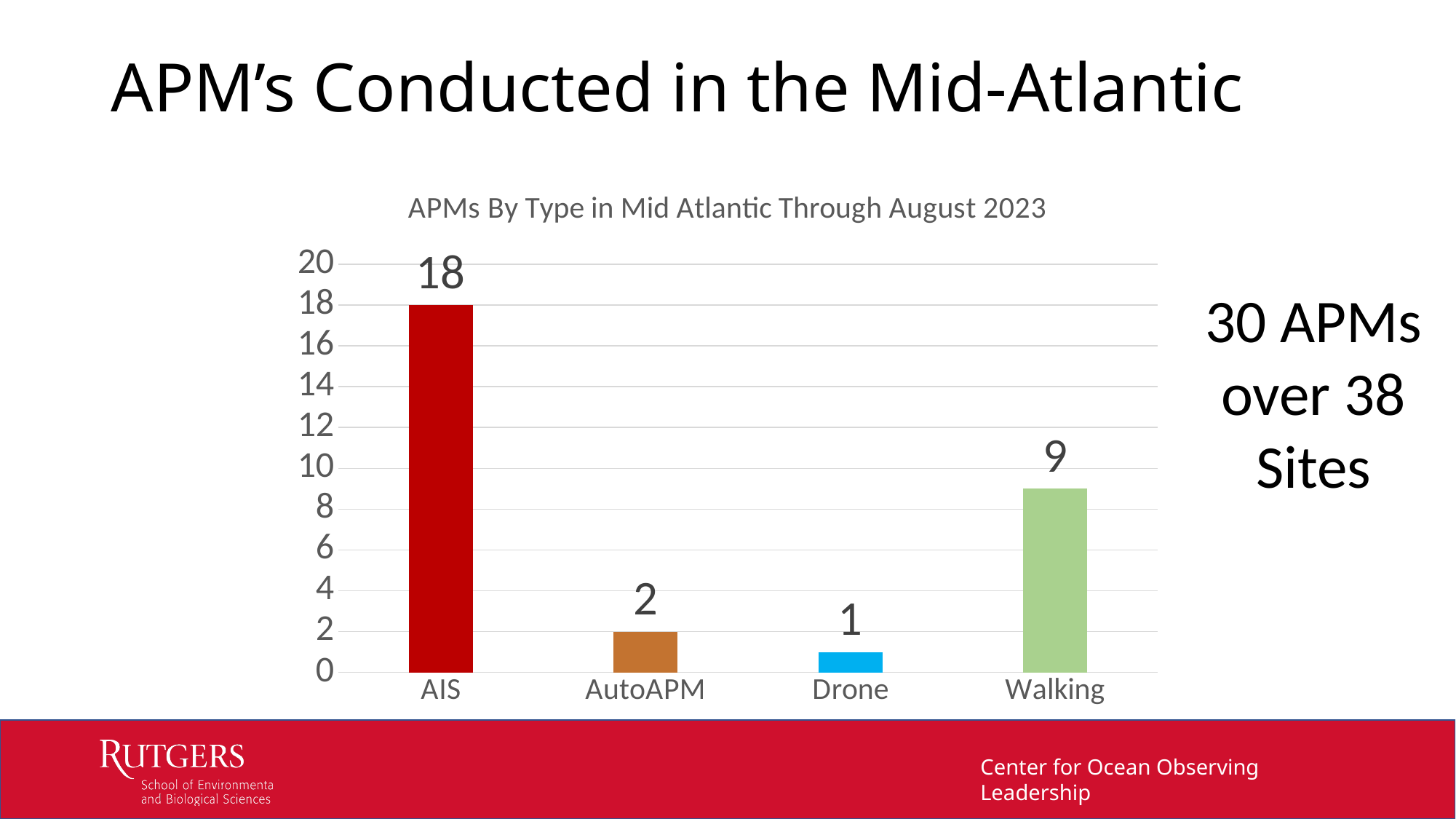
Is the value for AIS greater or less than 10? greater Which category has the lowest value? Drone How many categories are shown on the x axis? 4 What is the difference between the values for AIS and Walking? 9 What is the value for Walking? 9 Which is larger, the value for AutoAPM or the value for Walking? Walking Which category has the highest value? AIS What is the value for AutoAPM? 2 What kind of chart is shown on the slide? bar chart What is the title of the chart? APMs By Type in Mid Atlantic Through August 2023 What is the value for Drone? 1 What is the value for AIS? 18